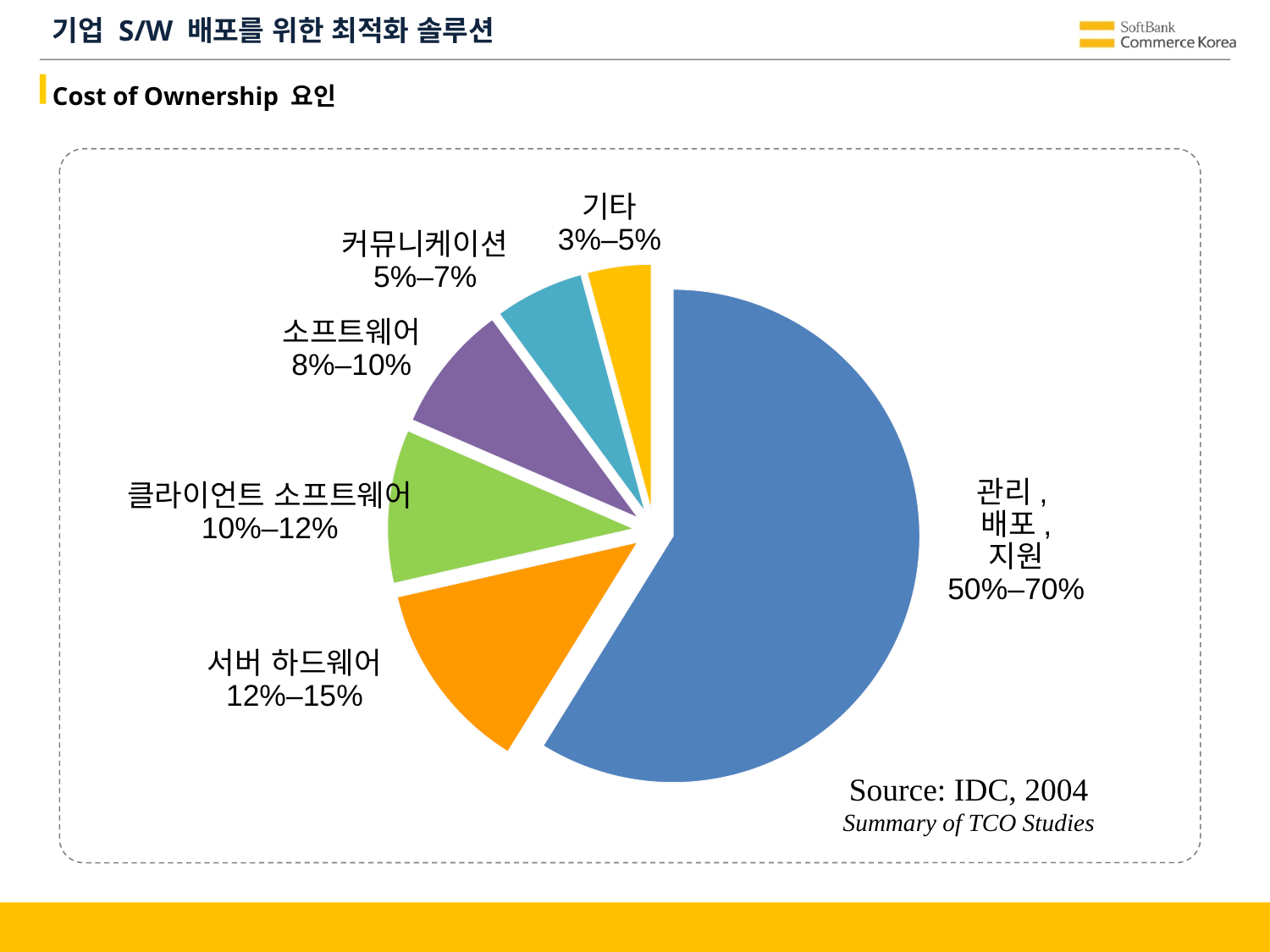
What share range is shown for 소프트웨어? 8%–10% What share range is shown for 커뮤니케이션? 5%–7% What kind of chart is shown on the slide? pie chart What share range is shown for 클라이언트 소프트웨어? 10%–12% Which slice is larger, 서버 하드웨어 or 커뮤니케이션? 서버 하드웨어 What share range is shown for 서버 하드웨어? 12%–15% What share range is shown for 관리, 배포, 지원? 50%–70% Which category has the largest slice of the pie? 관리, 배포, 지원 How many slices does the pie chart have? 6 What source is cited below the pie chart? IDC, 2004 Which category has the smallest slice of the pie? 기타 What share range is shown for 기타? 3%–5%